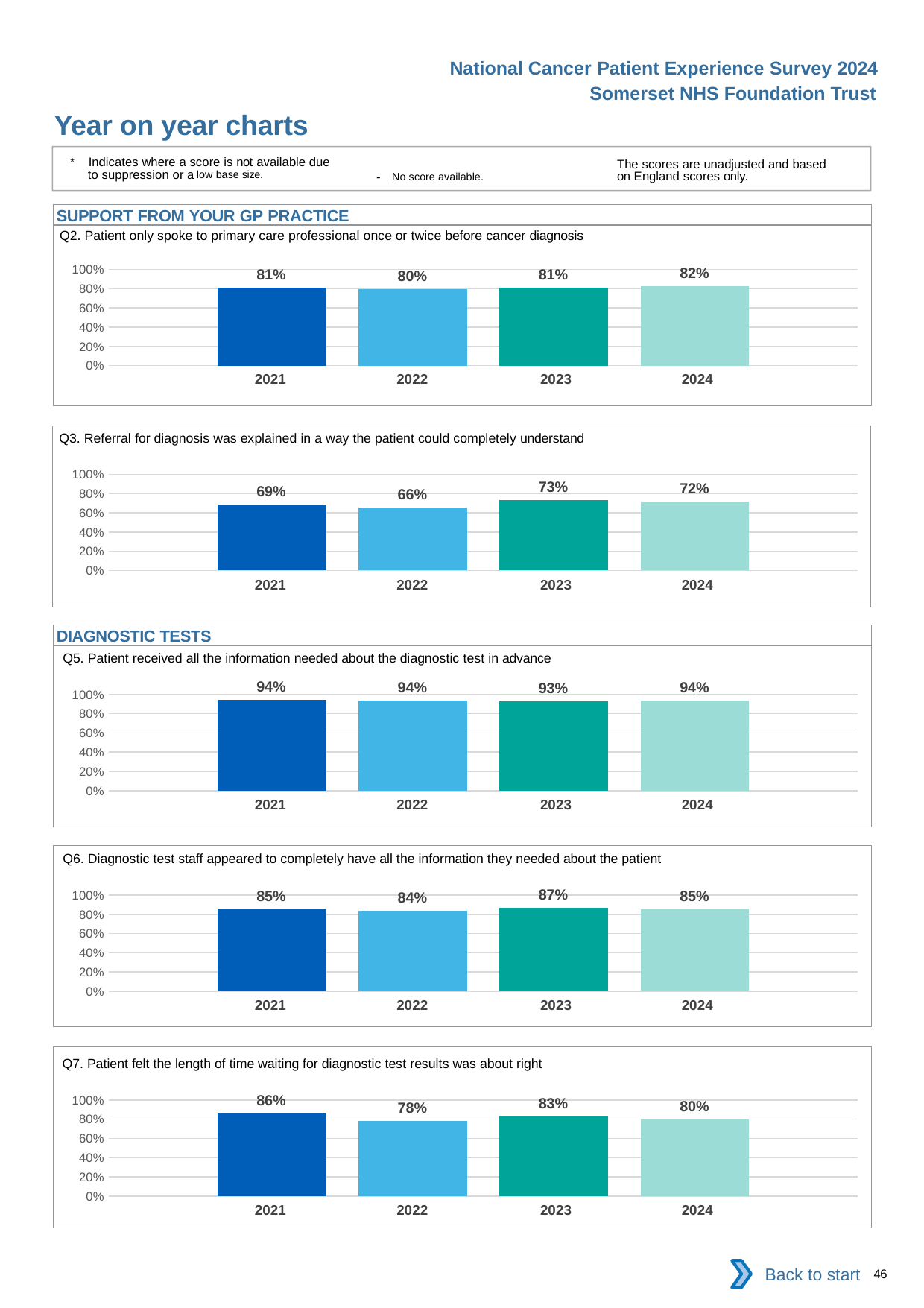
In the Q7 chart (patient felt the length of time waiting for diagnostic test results was about right), which year has the highest value? 2021 In the Q6 chart (diagnostic test staff appeared to completely have all the information they needed about the patient), which year has the highest value? 2023 How many charts are shown on the slide? 5 How many years are shown in the Q2 chart (patient only spoke to primary care professional once or twice before cancer diagnosis)? 4 In the Q2 chart (patient only spoke to primary care professional once or twice before cancer diagnosis), what is the value for 2024? 82% In the Q3 chart (referral for diagnosis was explained in a way the patient could completely understand), is the value for 2021 greater or less than 80%? less In the Q3 chart (referral for diagnosis was explained in a way the patient could completely understand), what is the difference between the 2023 and 2022 values? 7 percentage points In the Q7 chart (patient felt the length of time waiting for diagnostic test results was about right), is the value for 2023 larger than the value for 2024? Yes In the Q5 chart (patient received all the information needed about the diagnostic test in advance), what is the value for 2023? 93% In the Q3 chart (referral for diagnosis was explained in a way the patient could completely understand), which year has the lowest value? 2022 In the Q7 chart (patient felt the length of time waiting for diagnostic test results was about right), what is the difference between the 2021 and 2022 values? 8 percentage points What kind of chart is the Q5 chart (patient received all the information needed about the diagnostic test in advance)? Bar chart